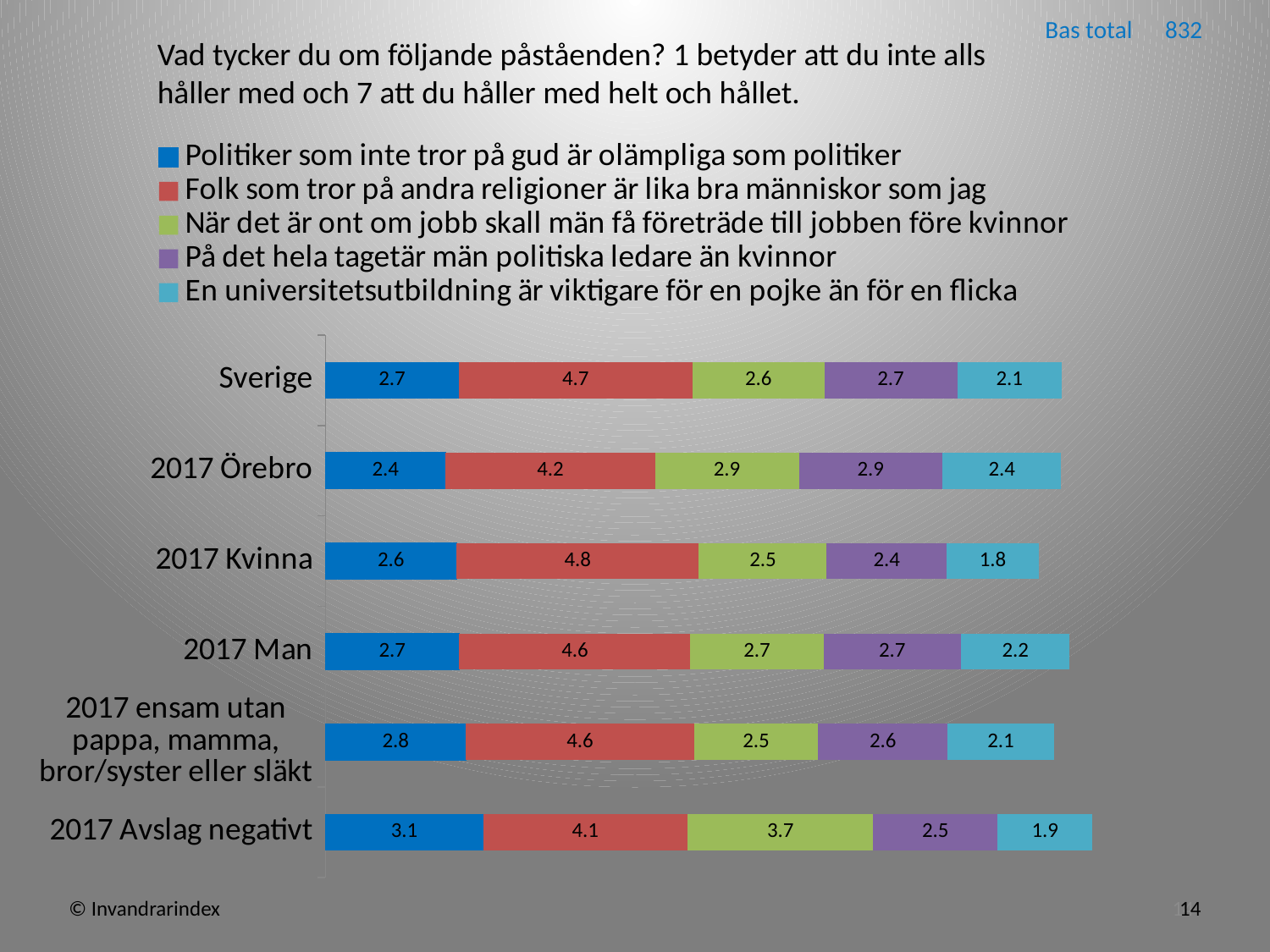
Which category has the highest value for the series "Politiker som inte tror på gud är olämpliga som politiker"? 2017 Avslag negativt What is the value for 2017 Avslag negativt for the series "När det är ont om jobb skall män få företräde till jobben före kvinnor"? 3.7 Which is larger for the series "Politiker som inte tror på gud är olämpliga som politiker": Sverige or 2017 Örebro? Sverige What is the difference between 2017 Kvinna and 2017 Man for the series "Folk som tror på andra religioner är lika bra människor som jag"? 0.2 What is the total of the stacked bar for 2017 Avslag negativt? 15.3 How many categories are shown on the chart? 6 Which category has the lowest value for the series "En universitetsutbildning är viktigare för en pojke än för en flicka"? 2017 Kvinna How many series does the legend list? 5 What is the value for 2017 Örebro for the series "På det hela tagetär män politiska ledare än kvinnor"? 2.9 What is the value for Sverige for the series "Folk som tror på andra religioner är lika bra människor som jag"? 4.7 What is the "Bas total" shown on the slide? 832 What kind of chart is shown on the slide? Stacked bar chart